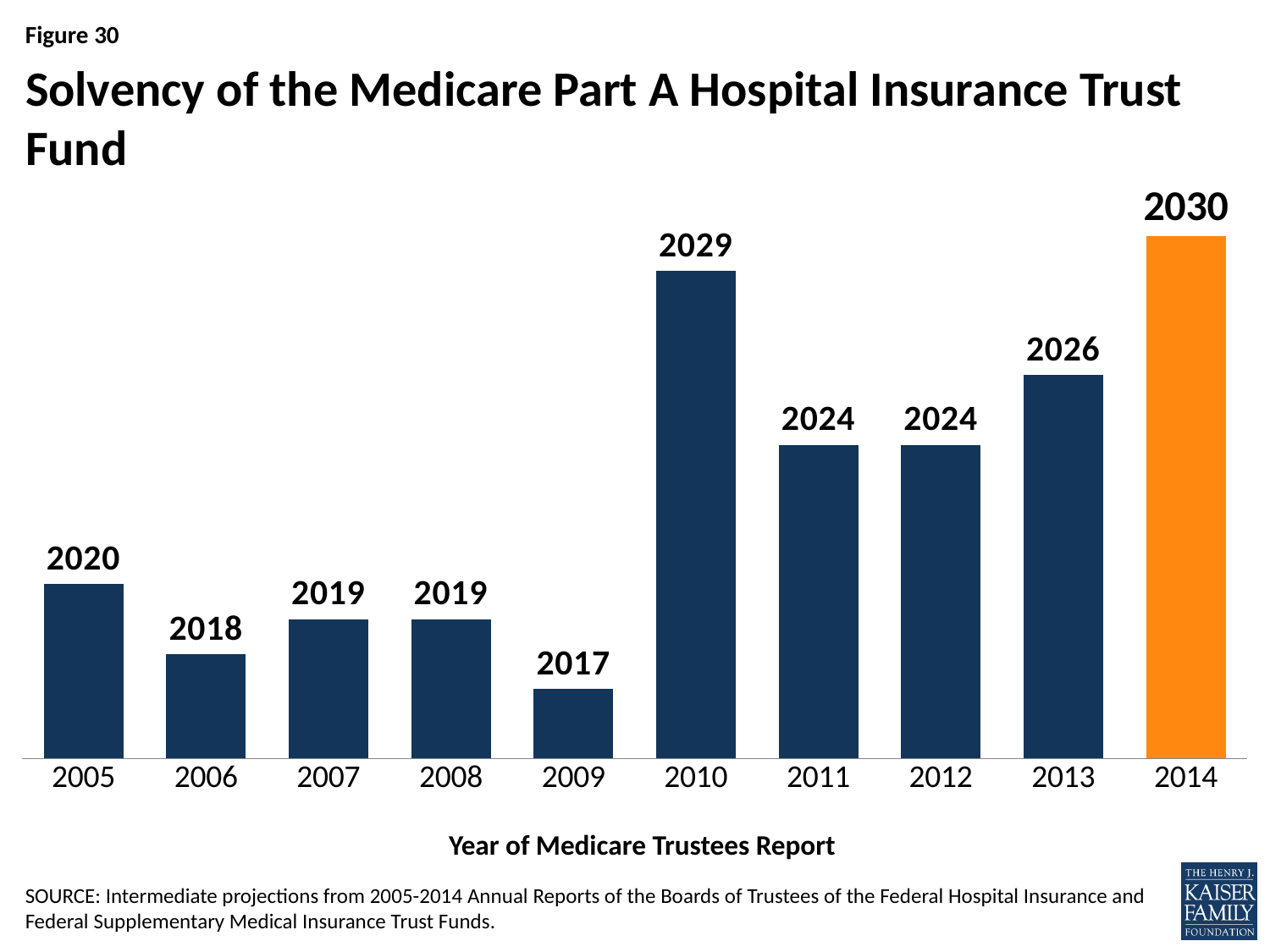
What kind of chart is shown on the slide? Bar chart Which bar is coloured orange rather than dark blue? 2014 What projected solvency year is shown for the 2009 Medicare Trustees Report? 2017 What projected solvency year is shown for the 2014 Medicare Trustees Report? 2030 How many years of Medicare Trustees Report are shown on the x axis? 10 Which year of Medicare Trustees Report has the highest projected solvency year? 2014 Which report year shows a later projected solvency year, 2005 or 2013? 2013 How many years later is the projected solvency year in the 2014 report than in the 2013 report? 4 What projected solvency year is shown for the 2006 Medicare Trustees Report? 2018 How many years later is the projected solvency year in the 2010 report than in the 2009 report? 12 Which year of Medicare Trustees Report has the lowest projected solvency year? 2009 What projected solvency year is shown for the 2010 Medicare Trustees Report? 2029